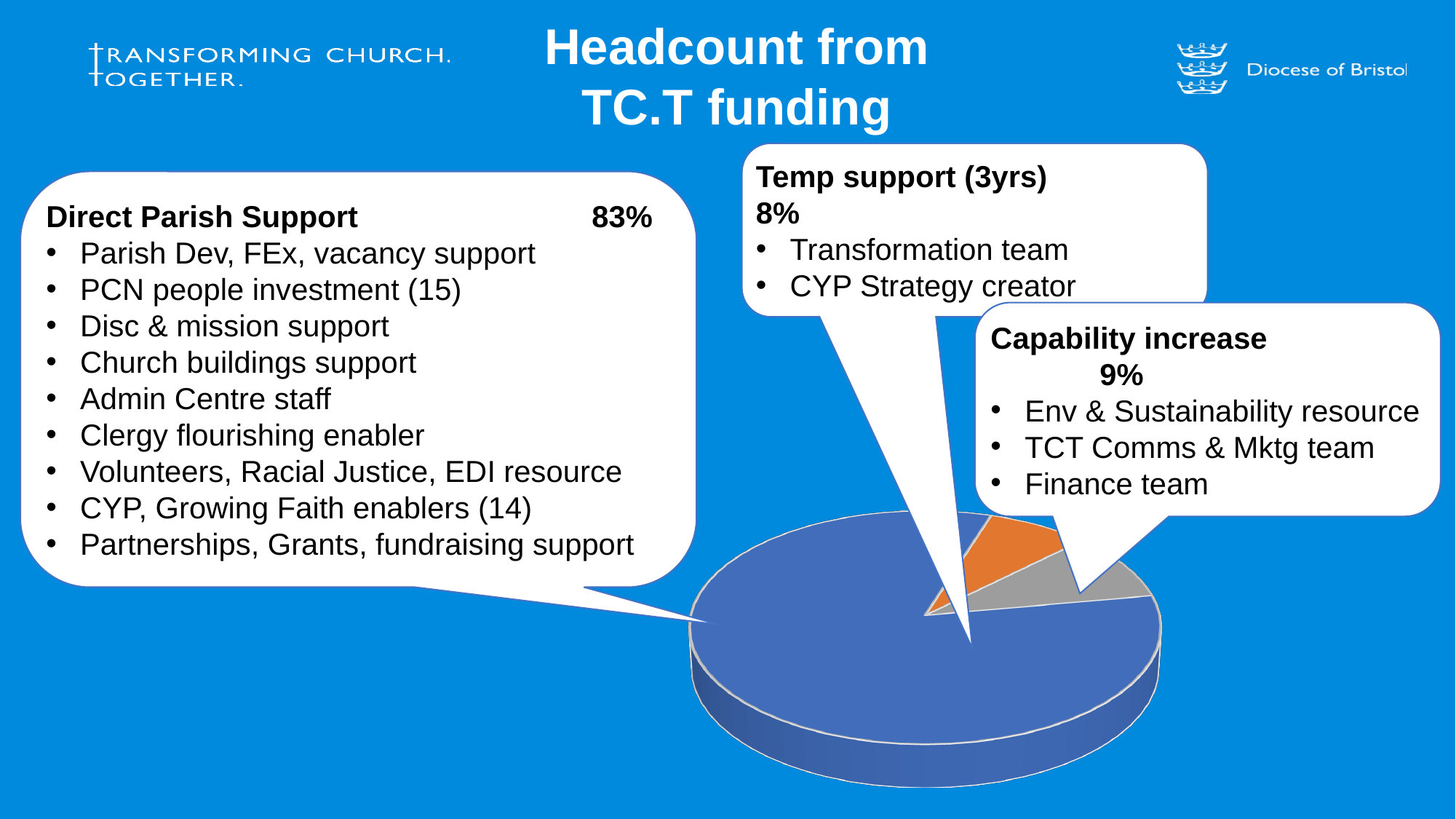
What is the difference in percentage points between Direct Parish Support and Capability increase? 74 What is the difference in percentage points between Capability increase and Temp support (3yrs)? 1 What share of the headcount is Direct Parish Support? 83% What is the title of the slide containing the pie chart? Headcount from TC.T funding What kind of chart is shown on the slide? pie chart What share of the headcount is Temp support (3yrs)? 8% Which category has the largest slice of the pie? Direct Parish Support What share of the headcount is Capability increase? 9% Which category has the smallest slice of the pie? Temp support (3yrs) How many slices does the pie chart have? 3 Which is larger, the Direct Parish Support slice or the Temp support (3yrs) slice? Direct Parish Support What colour is the Temp support (3yrs) slice of the pie? orange